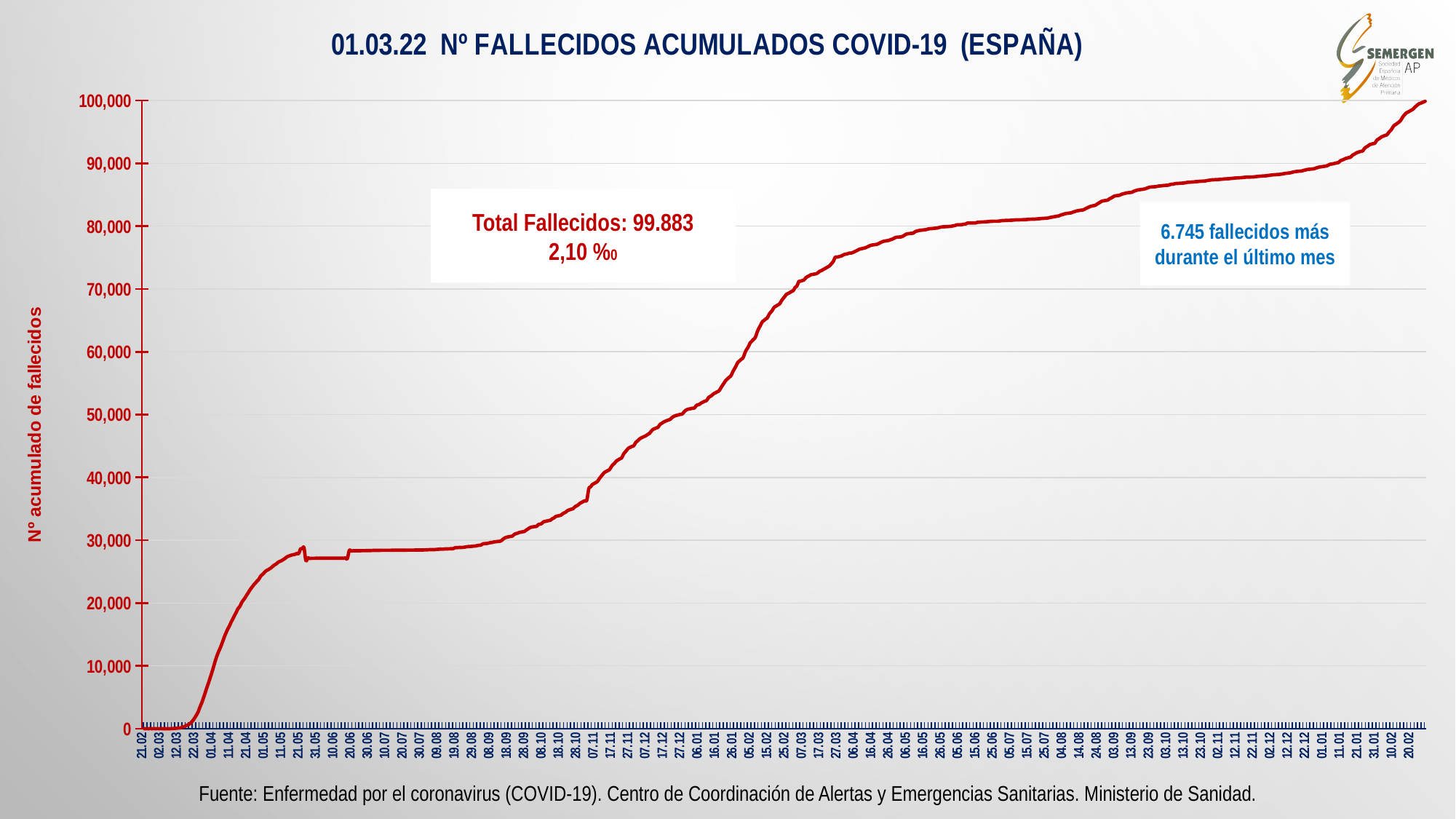
Is the value for 27.03 greater or less than 70,000? greater What is the title of the chart? 01.03.22 Nº FALLECIDOS ACUMULADOS COVID-19 (ESPAÑA) Is the value for 20.02 greater or less than 90,000? greater Is the value for 07.11 greater or less than 30,000? greater What total number of deaths (Total Fallecidos) is printed on the chart? 99.883 Which of the two dates has the larger value, 11.05 or 17.12? 17.12 Do the values rise or fall along the x axis from 21.02 to 20.02? rise According to the annotation, how many more deaths occurred during the last month? 6.745 What kind of chart is shown on the slide? line chart What is the label of the vertical axis? Nº acumulado de fallecidos